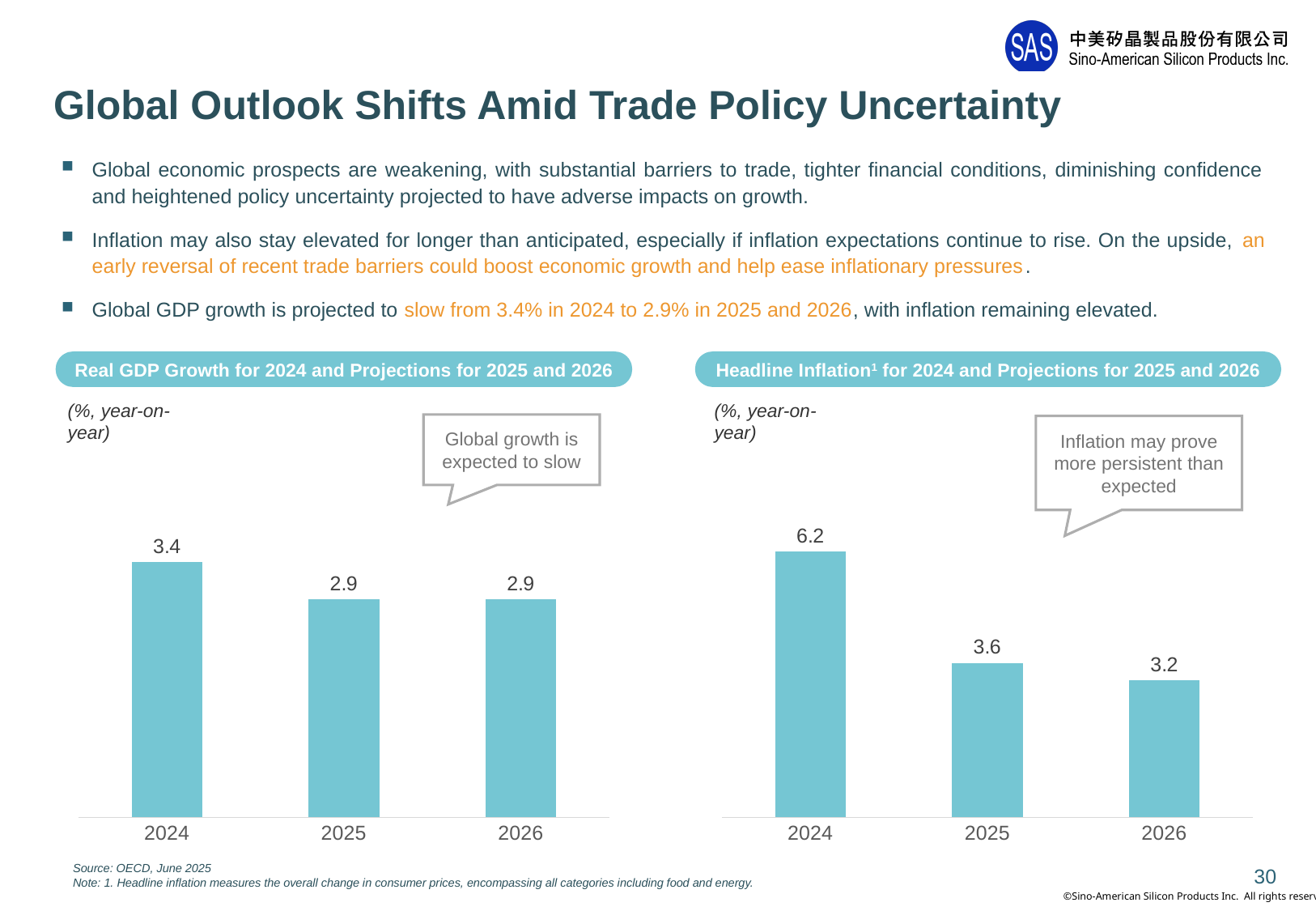
How many years are shown in the Real GDP Growth chart? 3 In the Real GDP Growth chart, what is the projected value for 2026? 2.9 In the Headline Inflation chart, which year has the highest value? 2024 In the Headline Inflation chart, what is the projected value for 2025? 3.6 What kind of chart is the Headline Inflation chart? bar chart In the Real GDP Growth chart, what is the value for 2024? 3.4 In the Headline Inflation chart, what is the value for 2024? 6.2 In the Headline Inflation chart, what is the difference between the 2024 value and the 2026 value? 3.0 In the Headline Inflation chart, is the value for 2025 larger or smaller than the value for 2026? larger In the Headline Inflation chart, do the values rise or fall from 2024 to 2026? fall In the Headline Inflation chart, which year has the lowest value? 2026 In the Real GDP Growth chart, what is the difference between the 2024 value and the 2025 value? 0.5